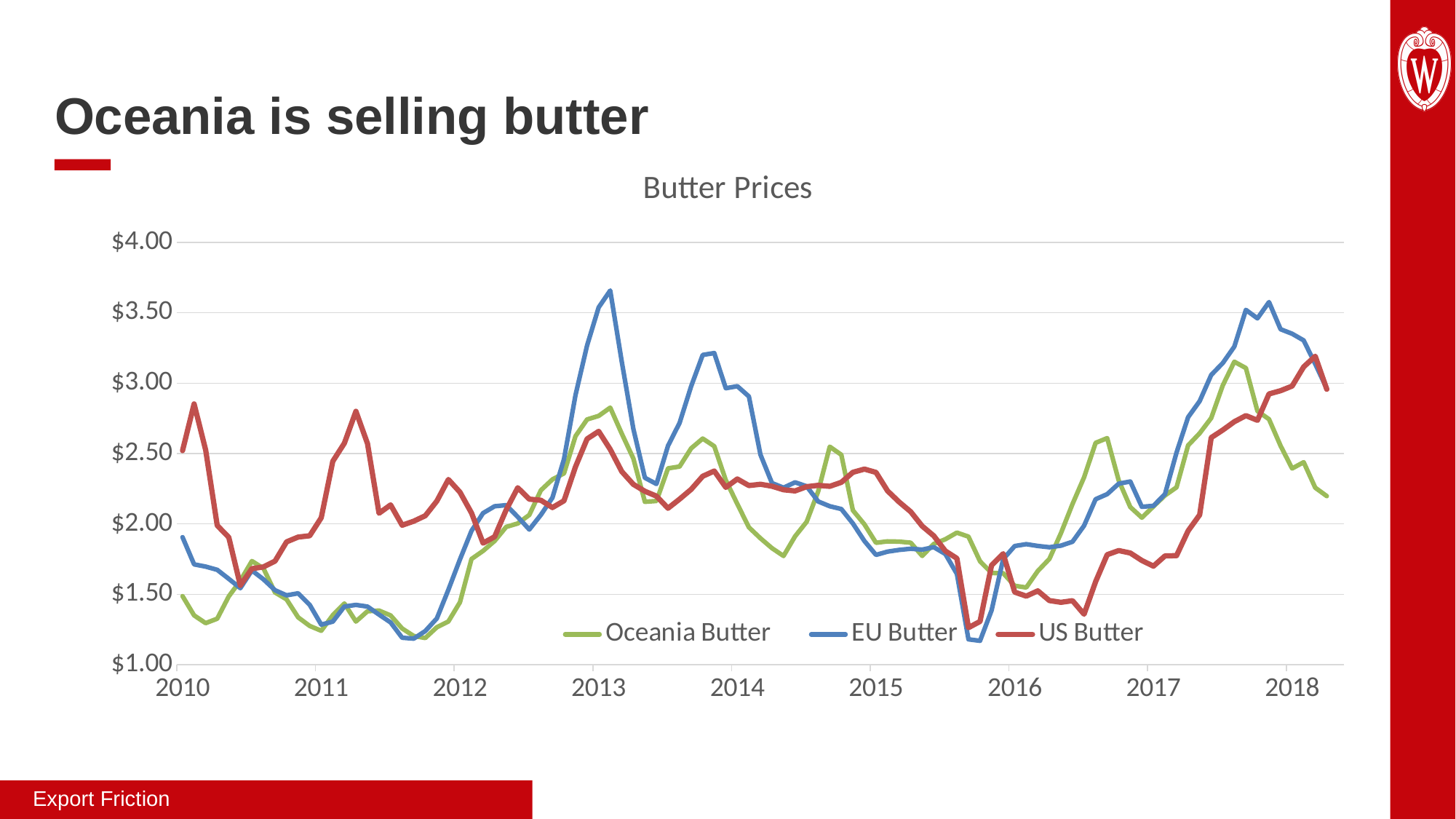
In mid-2016, which is higher, Oceania Butter or US Butter? Oceania Butter Is the peak value of EU Butter in early 2013 greater or less than $3.50? greater Does the Oceania Butter line rise or fall from its late-2017 peak to the end of the chart in 2018? fall Is the value of Oceania Butter at the right end of the chart (2018) greater or less than $2.50? less Is the peak of US Butter in early 2011 greater or less than $2.50? greater What is the title of the chart? Butter Prices How many series does the legend of the Butter Prices chart list? 3 At the right end of the chart in 2018, which is higher, US Butter or Oceania Butter? US Butter What kind of chart is shown on the slide? Line chart Which series reaches the highest price anywhere on the chart? EU Butter Which series is drawn in green in the Butter Prices chart? Oceania Butter